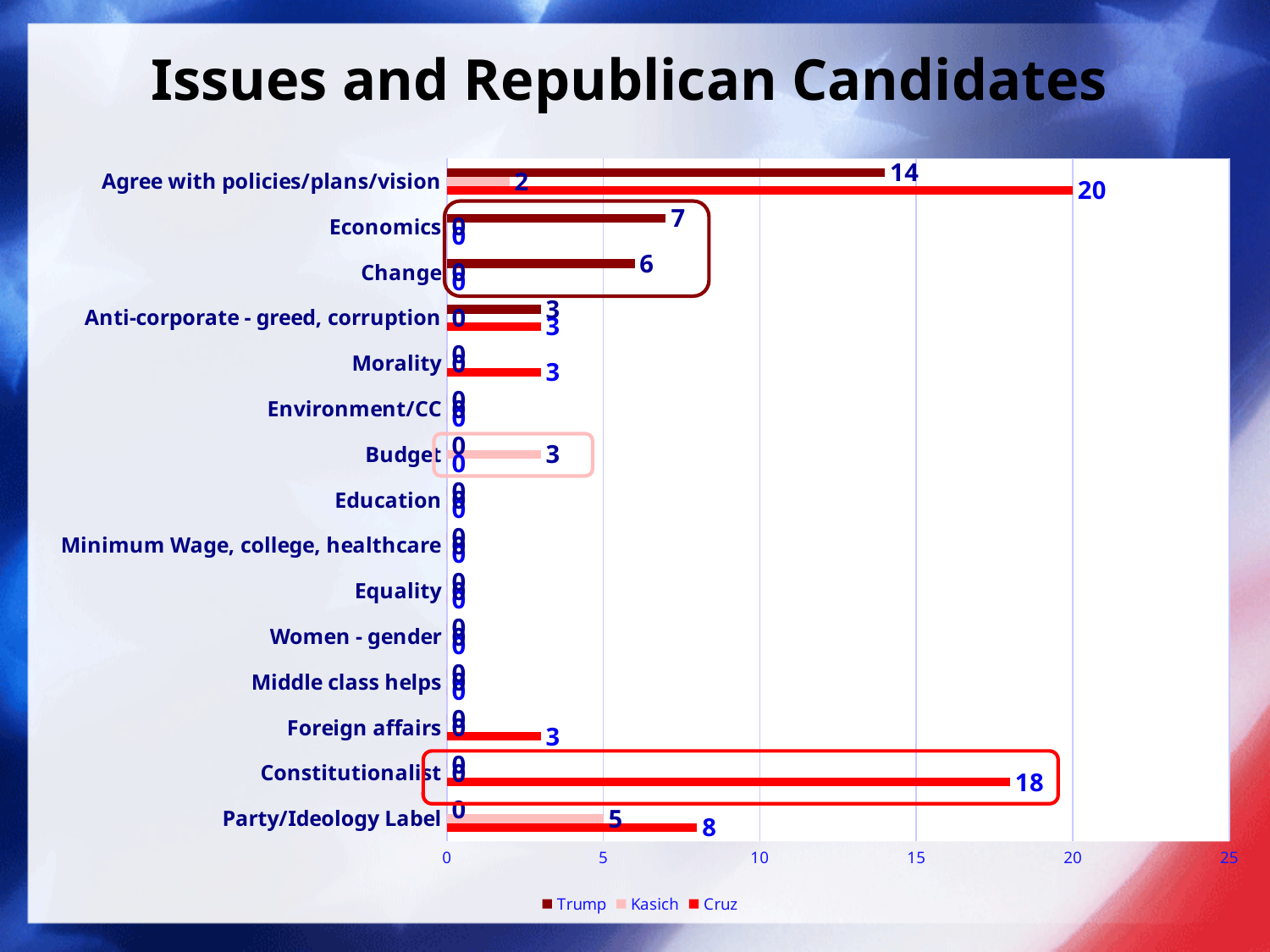
How many series does the legend list? 3 What is the value for Cruz on "Agree with policies/plans/vision"? 20 What kind of chart is shown on the slide? Bar chart How many categories are shown on the chart? 15 What is the value for Kasich on "Budget"? 3 What is the value for Kasich on "Party/Ideology Label"? 5 What is the value for Cruz on "Constitutionalist"? 18 What is the title of the chart on the slide? Issues and Republican Candidates Which category has the highest value for Cruz? Agree with policies/plans/vision What is the value for Trump on "Economics"? 7 What is the difference between the Cruz and Trump values on "Agree with policies/plans/vision"? 6 For Trump, which is larger: the value for "Economics" or the value for "Change"? Economics